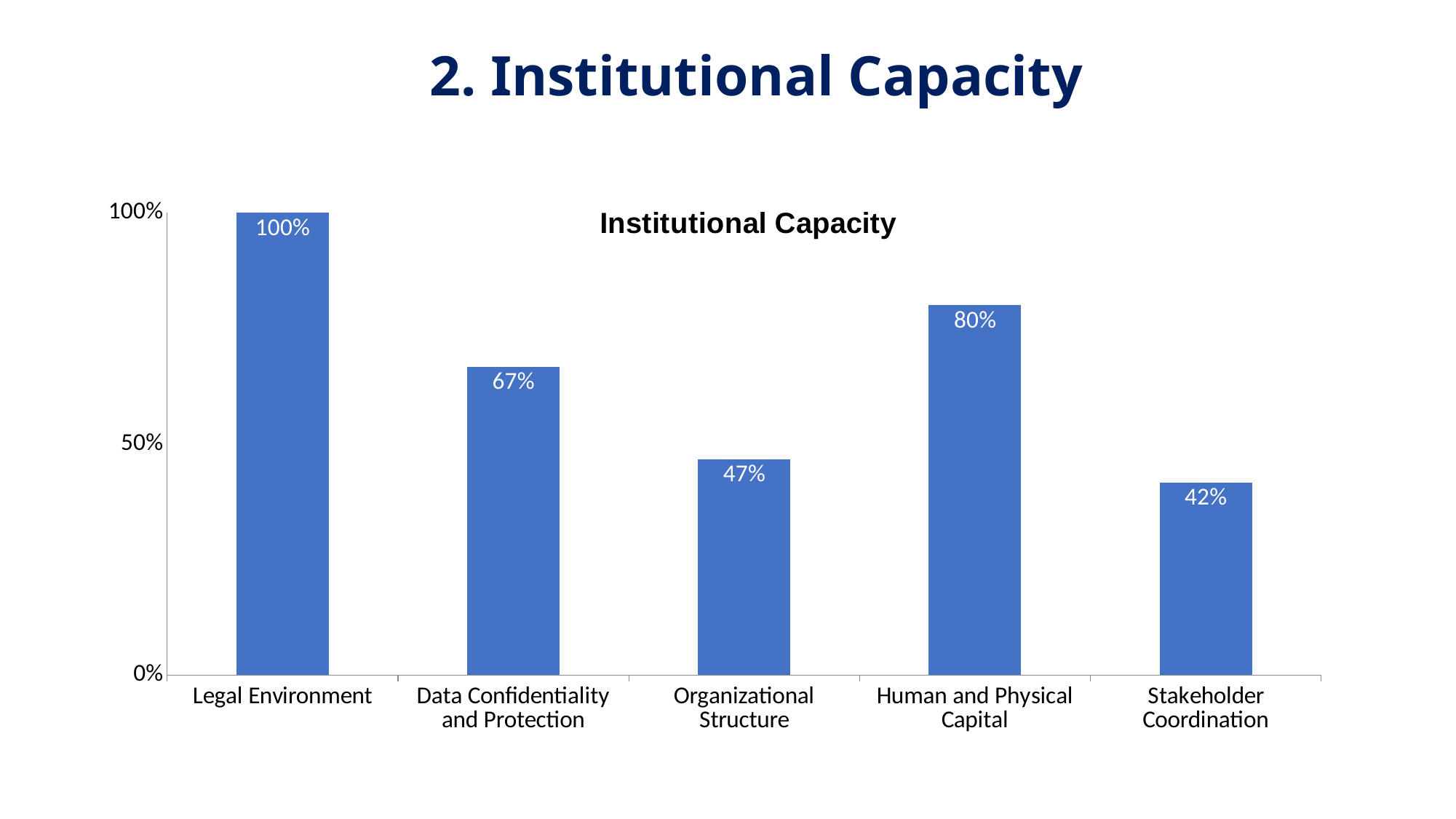
Is the value for Stakeholder Coordination greater or less than 50%? less Which category has the highest value? Legal Environment What kind of chart is shown on the slide? bar chart What is the value for Human and Physical Capital? 80% How many categories are shown on the chart? 5 What is the value for Stakeholder Coordination? 42% Which category has the lowest value? Stakeholder Coordination What is the difference between the values for Legal Environment and Human and Physical Capital? 20% What is the value for Organizational Structure? 47% Which is larger, the value for Data Confidentiality and Protection or the value for Organizational Structure? Data Confidentiality and Protection What is the value for Data Confidentiality and Protection? 67% What is the value for Legal Environment? 100%